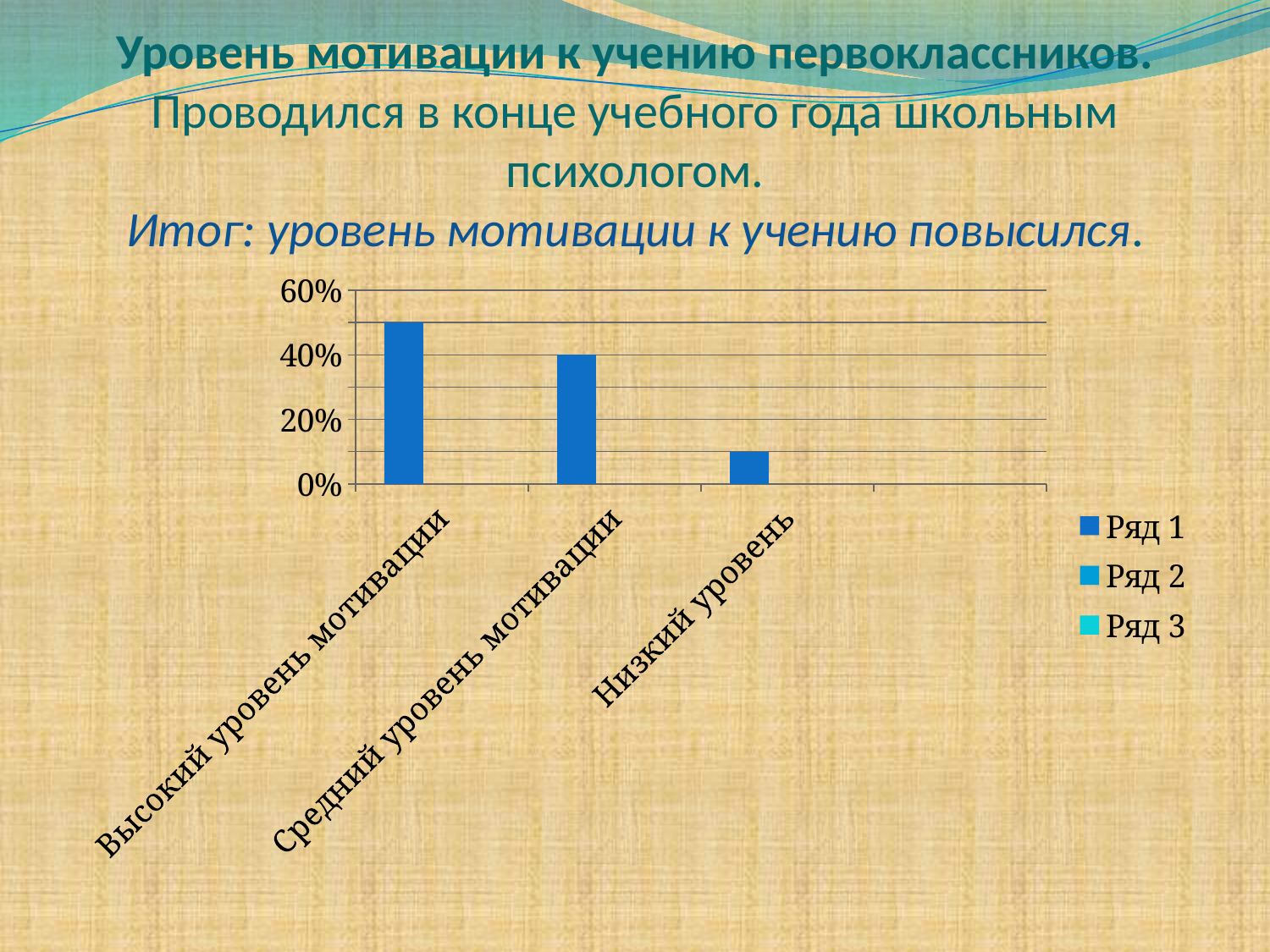
How many categories are shown on the x axis of the chart? 3 Which is larger, the value for Высокий уровень мотивации or the value for Средний уровень мотивации? Высокий уровень мотивации What is the first entry in the chart's legend? Ряд 1 What kind of chart is shown on the slide? bar chart Which category has the highest bar? Высокий уровень мотивации Is the value for Низкий уровень greater or less than 20%? less How many series does the chart's legend list? 3 What is the highest value labelled on the vertical axis? 60% Do the bar values rise or fall from left to right along the x axis? fall What is the value for Средний уровень мотивации? 40% Which category has the lowest bar? Низкий уровень Is the value for Высокий уровень мотивации greater or less than 40%? greater